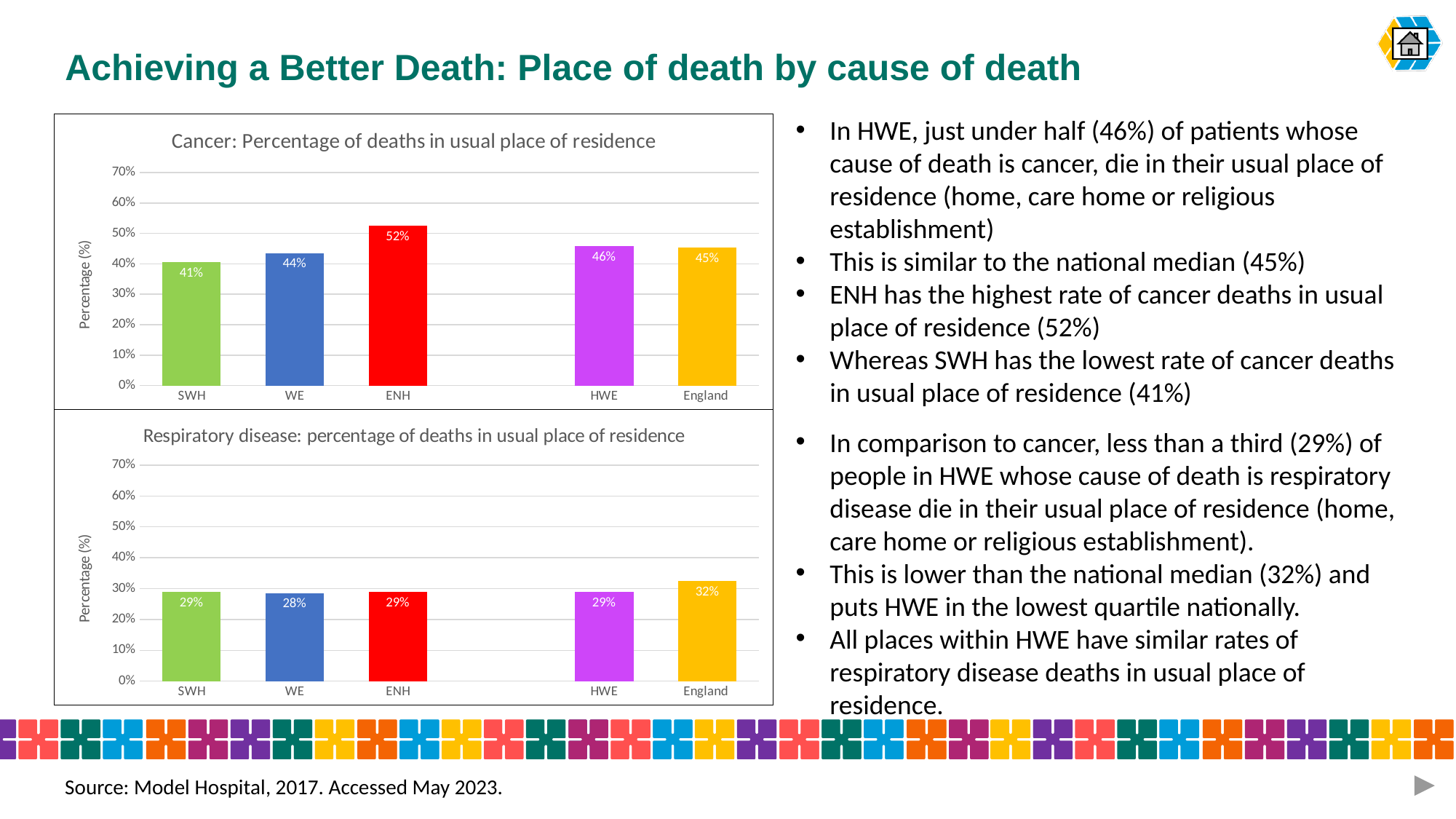
In the Cancer chart, which is larger, the value for WE or the value for England? England In the Cancer chart, which category has the highest percentage? ENH In the Cancer chart, what is the value for HWE? 46% How many categories are shown in the Cancer chart? 5 In the Respiratory disease chart, what is the difference between England and HWE? 3% What type of chart is the Respiratory disease chart? Bar chart In the Respiratory disease chart, what is the value for England? 32% In the Cancer chart, what is the difference between ENH and SWH? 11% In the Respiratory disease chart, which category has the highest percentage? England In the Cancer chart, what is the percentage of deaths in usual place of residence for ENH? 52% In the Respiratory disease chart, what is the value for WE? 28% In the Cancer chart, which category has the lowest percentage? SWH